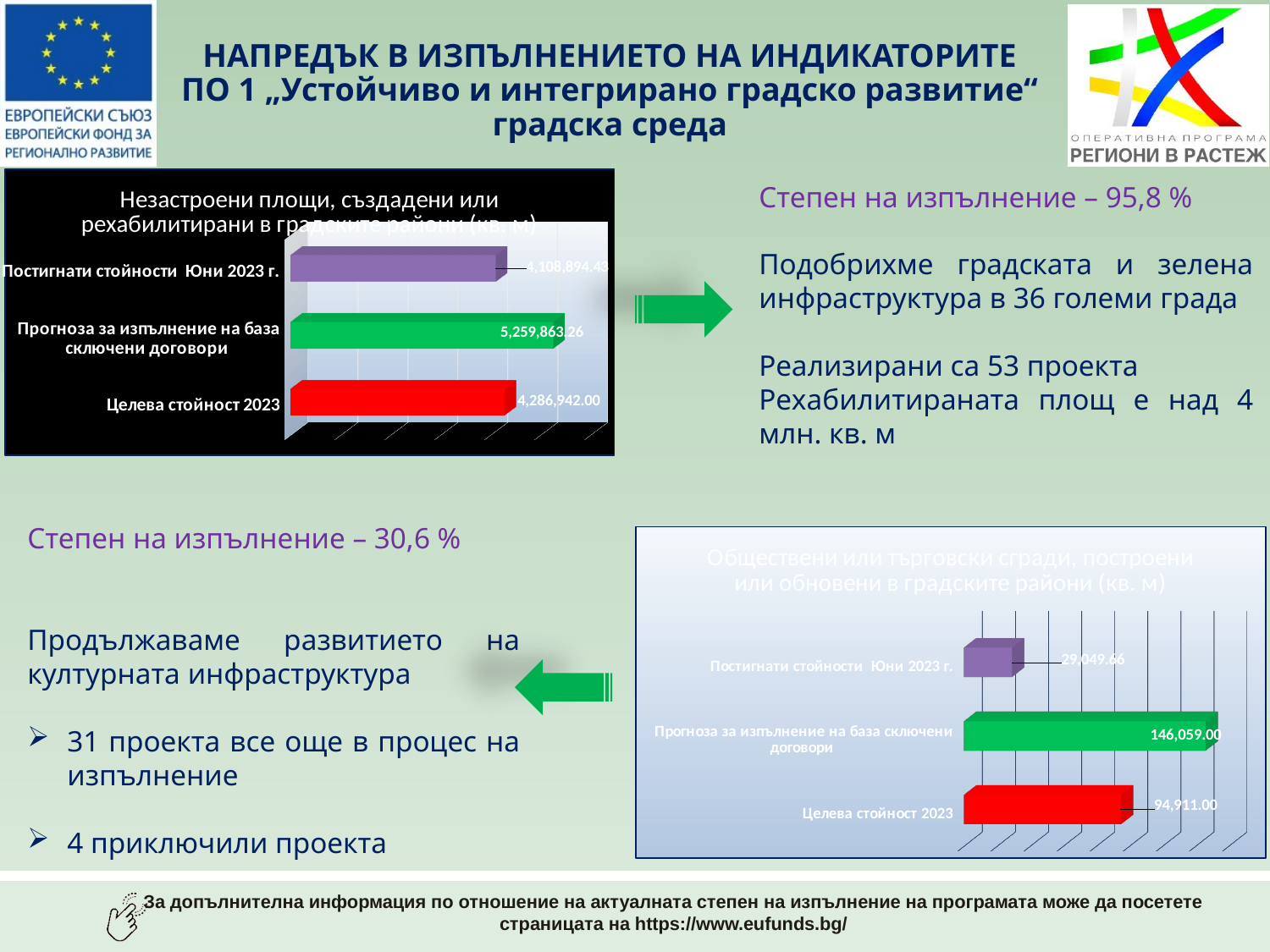
In the bottom-right chart (Обществени или търговски сгради), what is the value for Целева стойност 2023? 94,911.00 In the top-left chart (Незастроени площи), how many bars are plotted? 3 In the bottom-right chart (Обществени или търговски сгради), what is the value for Постигнати стойности Юни 2023 г.? 29,049.66 In the bottom-right chart (Обществени или търговски сгради), what is the value for Прогноза за изпълнение на база сключени договори? 146,059.00 In the top-left chart (Незастроени площи), what is the value for Прогноза за изпълнение на база сключени договори? 5,259,863.26 In the top-left chart (Незастроени площи), which category has the lowest value? Постигнати стойности Юни 2023 г. In the top-left chart (Незастроени площи), which category has the highest value? Прогноза за изпълнение на база сключени договори In the bottom-right chart (Обществени или търговски сгради), what is the difference between Прогноза за изпълнение на база сключени договори and Целева стойност 2023? 51,148.00 In the bottom-right chart (Обществени или търговски сгради), which category has the highest value? Прогноза за изпълнение на база сключени договори In the bottom-right chart (Обществени или търговски сгради), which is larger: Целева стойност 2023 or Постигнати стойности Юни 2023 г.? Целева стойност 2023 In the top-left chart (Незастроени площи), what is the value for Целева стойност 2023? 4,286,942.00 What type of chart is the top-left chart (Незастроени площи)? Bar chart